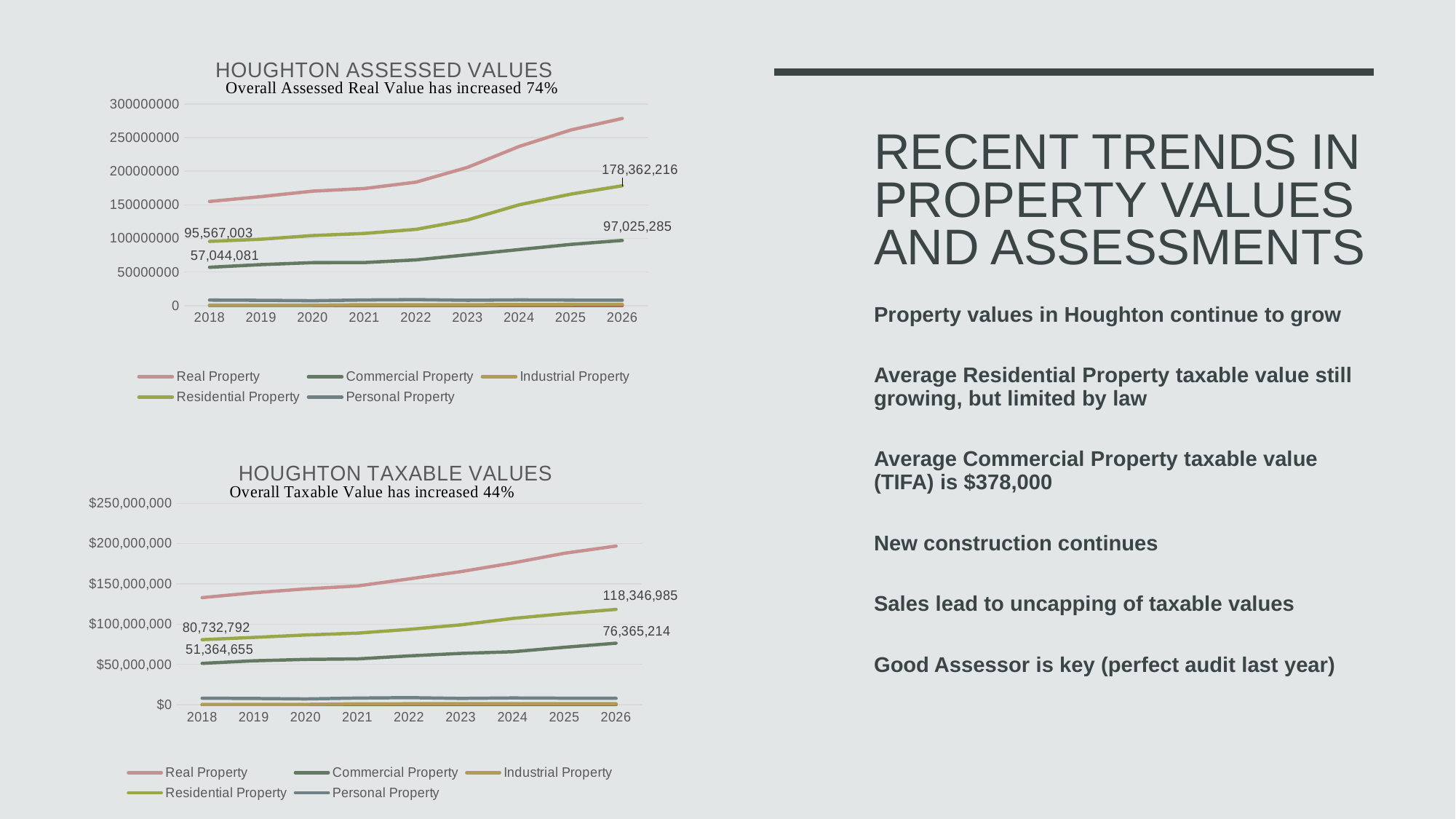
In the Houghton Taxable Values chart, what is the labeled value for Commercial Property in 2026? 76,365,214 In the Houghton Assessed Values chart, is the value for Real Property in 2026 greater or less than 250000000? greater In the Houghton Assessed Values chart, by how much did the labeled Residential Property value increase from 2018 to 2026? 82,795,213 In the Houghton Assessed Values chart, what is the labeled value for Commercial Property in 2018? 57,044,081 How many series does the legend of the Houghton Taxable Values chart list? 5 In the Houghton Assessed Values chart, what is the labeled value for Residential Property in 2026? 178,362,216 In the Houghton Assessed Values chart, which series has the highest values across all years? Real Property What type of chart is the Houghton Taxable Values chart? Line chart In the Houghton Taxable Values chart, what is the labeled value for Residential Property in 2018? 80,732,792 How many years are shown on the x axis of the Houghton Assessed Values chart? 9 In the Houghton Taxable Values chart, by how much did the labeled Commercial Property value increase from 2018 to 2026? 25,000,559